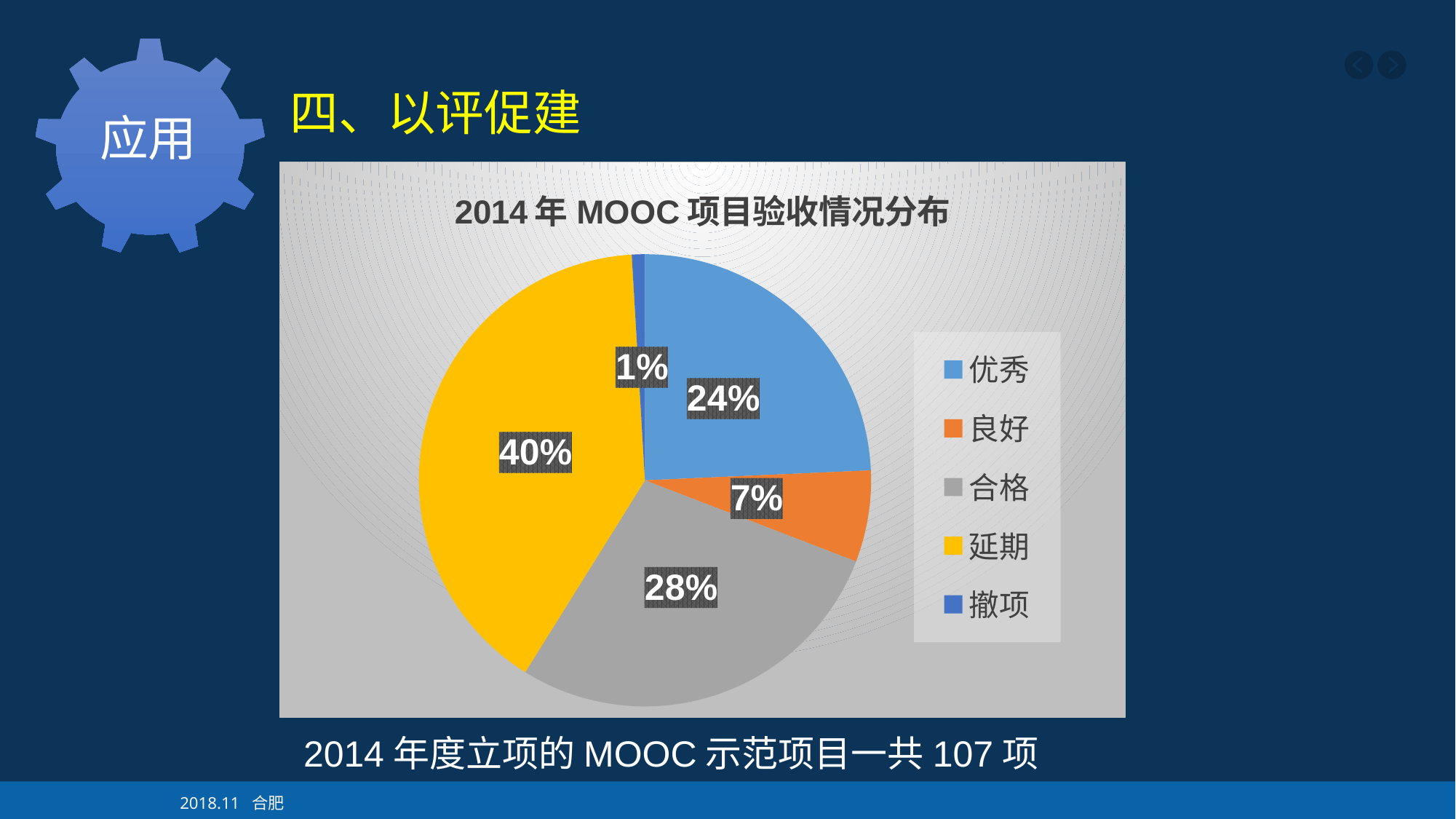
What share of the pie does 良好 represent? 7% What is the difference between the shares of 延期 and 合格? 12% How many categories does the legend list? 5 Which is larger, the share of 优秀 or the share of 良好? 优秀 What share of the pie does 合格 represent? 28% What is the title of the chart? 2014年MOOC项目验收情况分布 What share of the pie does 优秀 represent? 24% What share of the pie does 撤项 represent? 1% Which category has the largest share of the pie? 延期 Which category has the smallest share of the pie? 撤项 What share of the pie does 延期 represent? 40% What type of chart is shown on the slide? pie chart